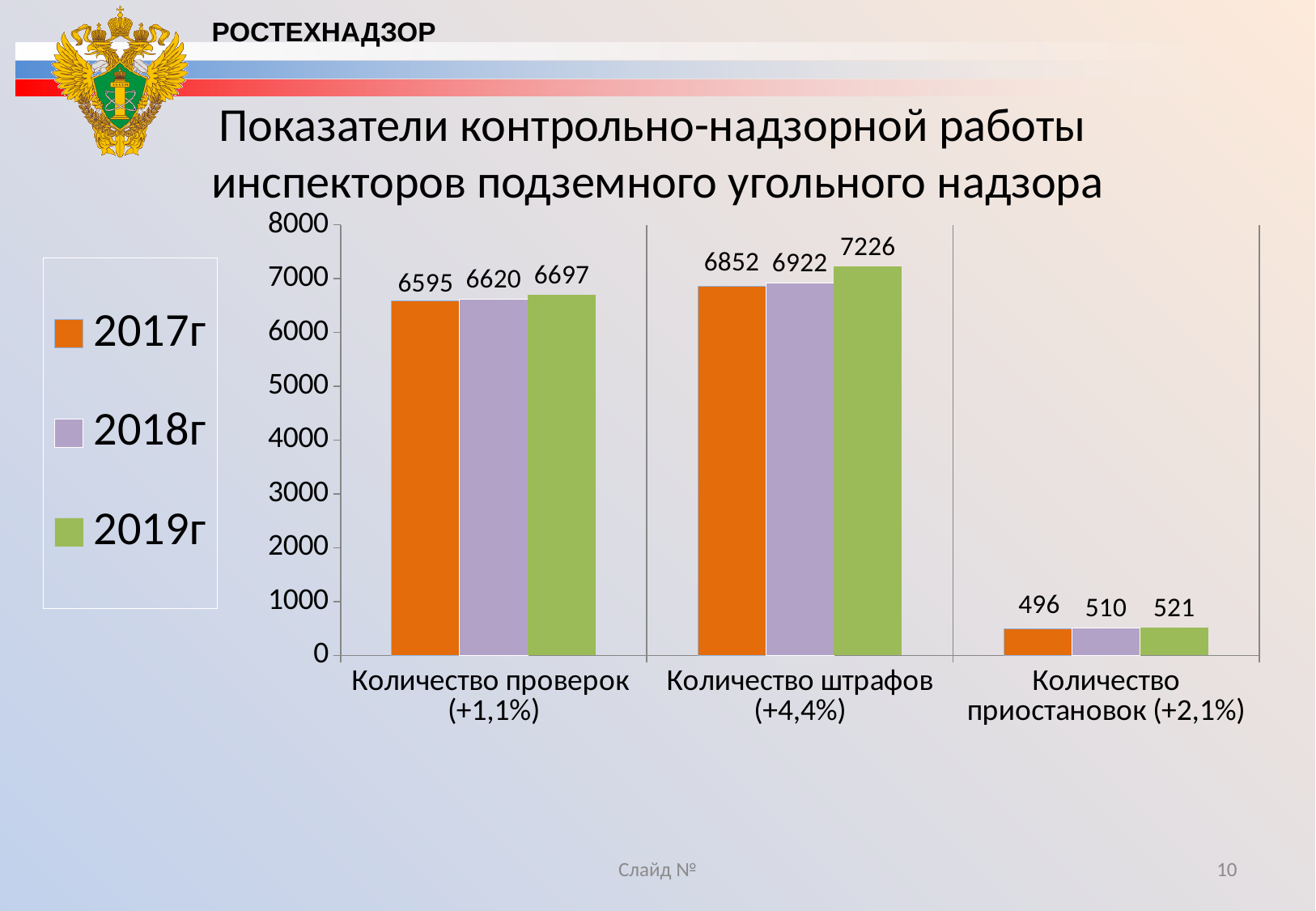
What is the difference between the 2019г and 2018г values for Количество приостановок (+2,1%)? 11 What is the difference between the 2019г and 2017г values for Количество штрафов (+4,4%)? 374 Which is larger: the 2018г value for Количество проверок (+1,1%) or the 2018г value for Количество штрафов (+4,4%)? Количество штрафов (+4,4%) How many categories are shown on the x axis? 3 What is the value for 2019г in the category Количество штрафов (+4,4%)? 7226 What is the value for 2018г in the category Количество приостановок (+2,1%)? 510 Which year has the highest value in the category Количество штрафов (+4,4%)? 2019г What is the value for 2017г in the category Количество проверок (+1,1%)? 6595 What kind of chart is shown on the slide? bar chart Which category has the lowest values across all three years? Количество приостановок (+2,1%) Is the 2017г value for Количество приостановок (+2,1%) greater or less than 1000? less How many series does the legend list? 3